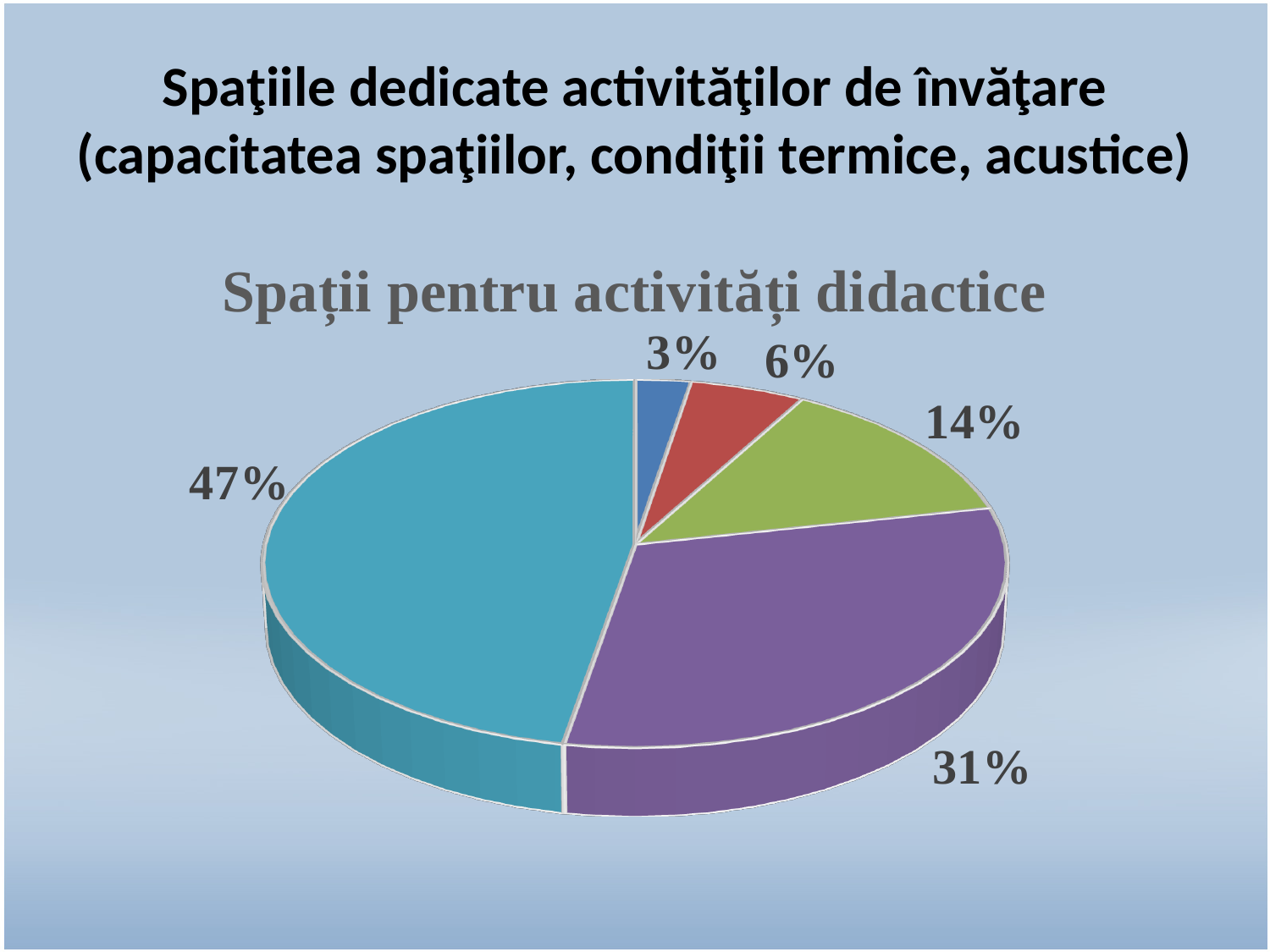
How many slices does the pie chart have? 5 What percentage is shown for the red slice? 6% What kind of chart is shown on the slide? pie chart What colour is the largest slice of the pie chart? teal Which slice is larger, the green slice or the red slice? green slice What is the smallest share shown in the pie chart? 3% What is the difference in percentage points between the teal slice (47%) and the purple slice (31%)? 16 What is the largest share shown in the pie chart? 47% What percentage is shown for the green slice? 14% What percentage is shown for the purple slice? 31% What percentage is shown for the blue (dark blue) slice? 3% What is the title of the chart? Spații pentru activități didactice